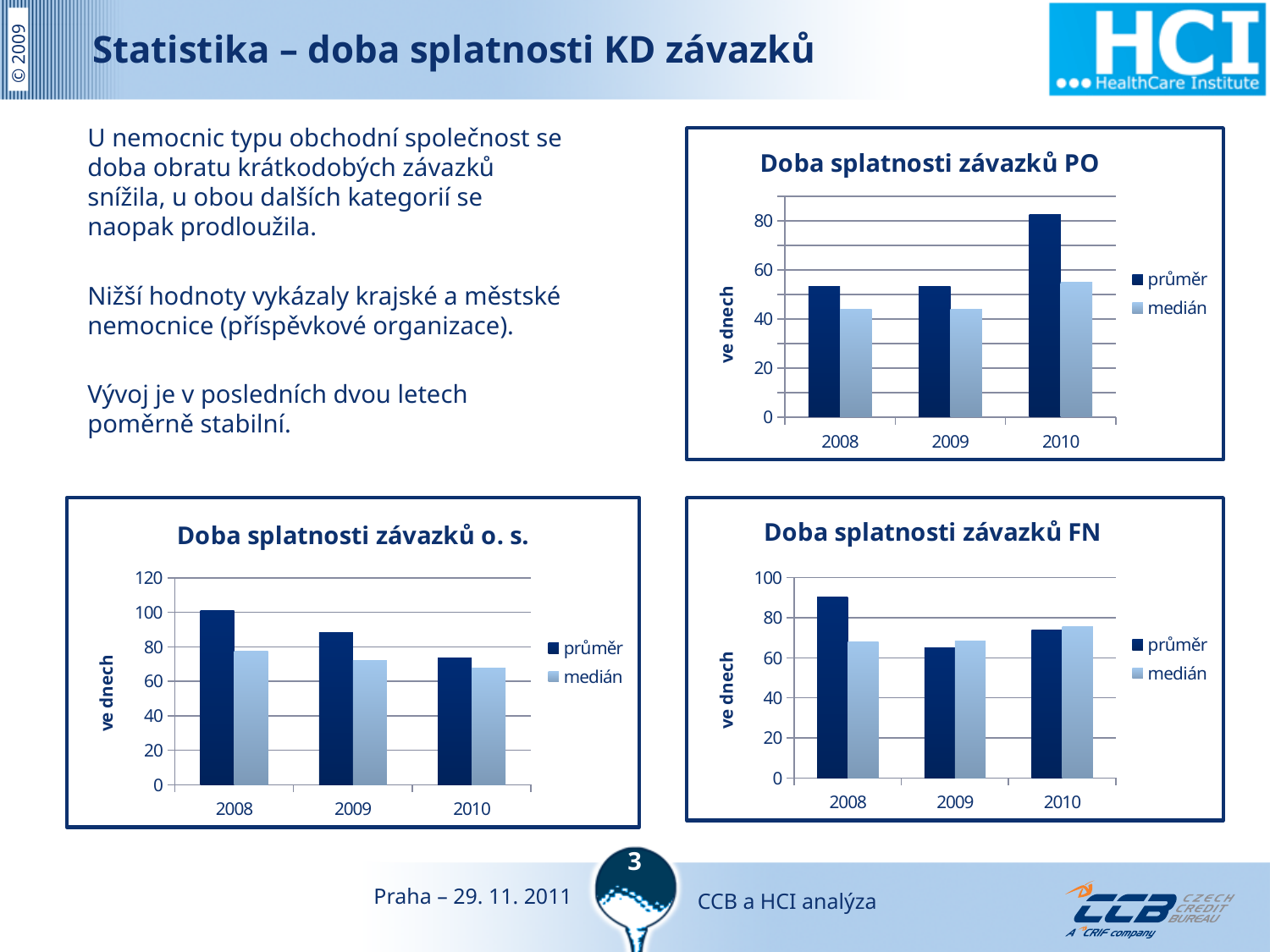
What kind of chart is the chart titled "Doba splatnosti závazků FN"? bar chart In the chart titled "Doba splatnosti závazků o. s.", is the průměr value for 2008 greater or less than 80? greater In the chart titled "Doba splatnosti závazků FN", which year has the highest průměr value? 2008 In the chart titled "Doba splatnosti závazků o. s.", which year has the lowest medián value? 2010 In the chart titled "Doba splatnosti závazků PO", how many series does the legend list? 2 In the chart titled "Doba splatnosti závazků o. s.", do the průměr values rise or fall from 2008 to 2010? fall In the chart titled "Doba splatnosti závazků PO", is the průměr value for 2010 greater or less than 80? greater In the chart titled "Doba splatnosti závazků PO", is the medián value for 2008 greater or less than 60? less In the chart titled "Doba splatnosti závazků o. s.", which is larger for 2008, průměr or medián? průměr In the chart titled "Doba splatnosti závazků PO", which year has the highest průměr value? 2010 In the chart titled "Doba splatnosti závazků FN", how many years are shown on the x axis? 3